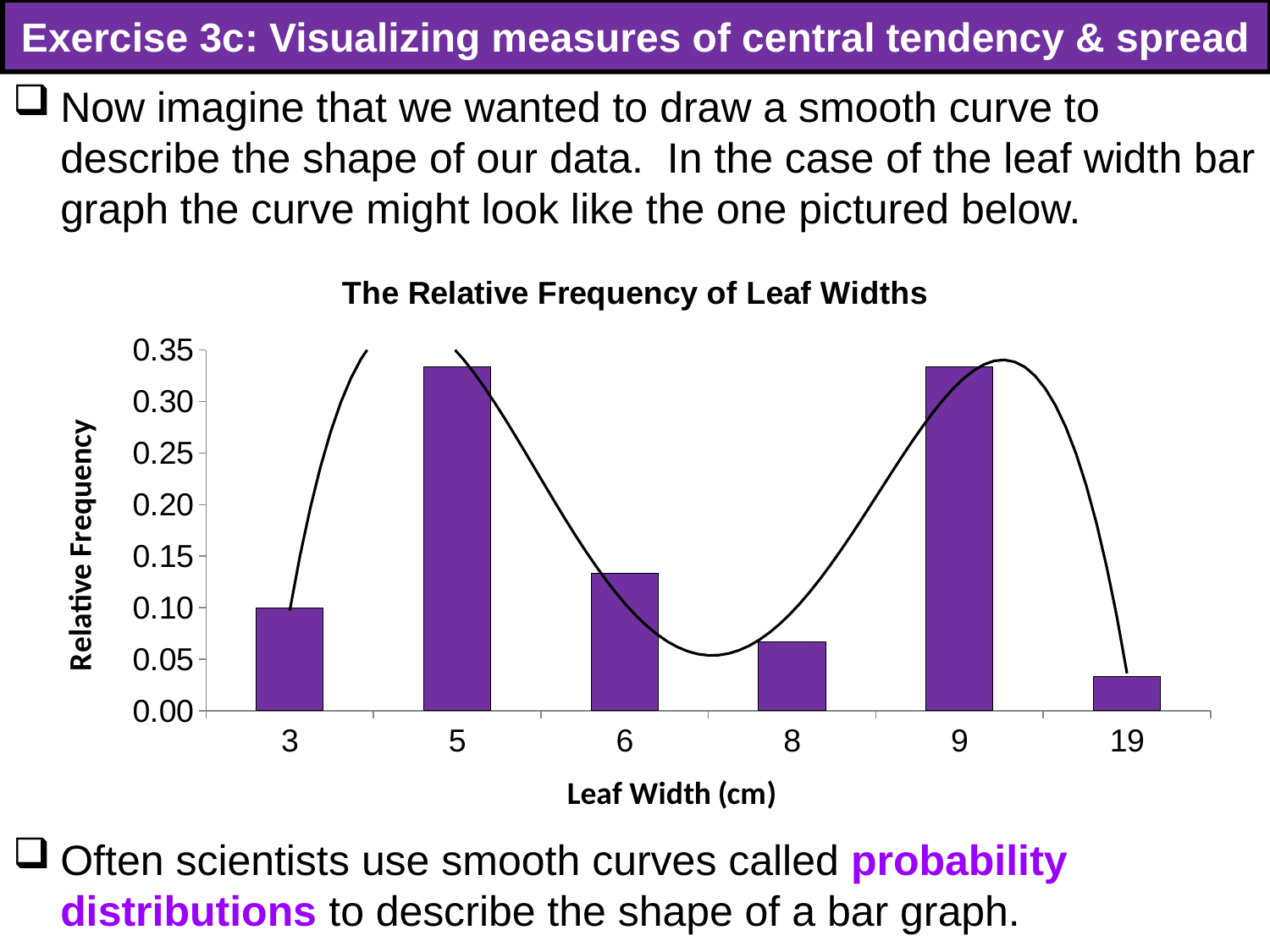
Is the relative frequency for a leaf width of 8 cm greater or less than 0.05? greater Which leaf width has the lowest relative frequency? 19 Is the relative frequency for a leaf width of 5 cm greater or less than 0.30? greater Is the relative frequency for a leaf width of 19 cm greater or less than 0.05? less What type of chart is shown on the slide? bar chart Which has a higher relative frequency, a leaf width of 6 cm or 8 cm? 6 What is the relative frequency for a leaf width of 3 cm? 0.10 What is the label of the x axis? Leaf Width (cm) Which has a higher relative frequency, a leaf width of 3 cm or 19 cm? 3 What is the title of the chart? The Relative Frequency of Leaf Widths How many leaf width categories are shown on the x axis? 6